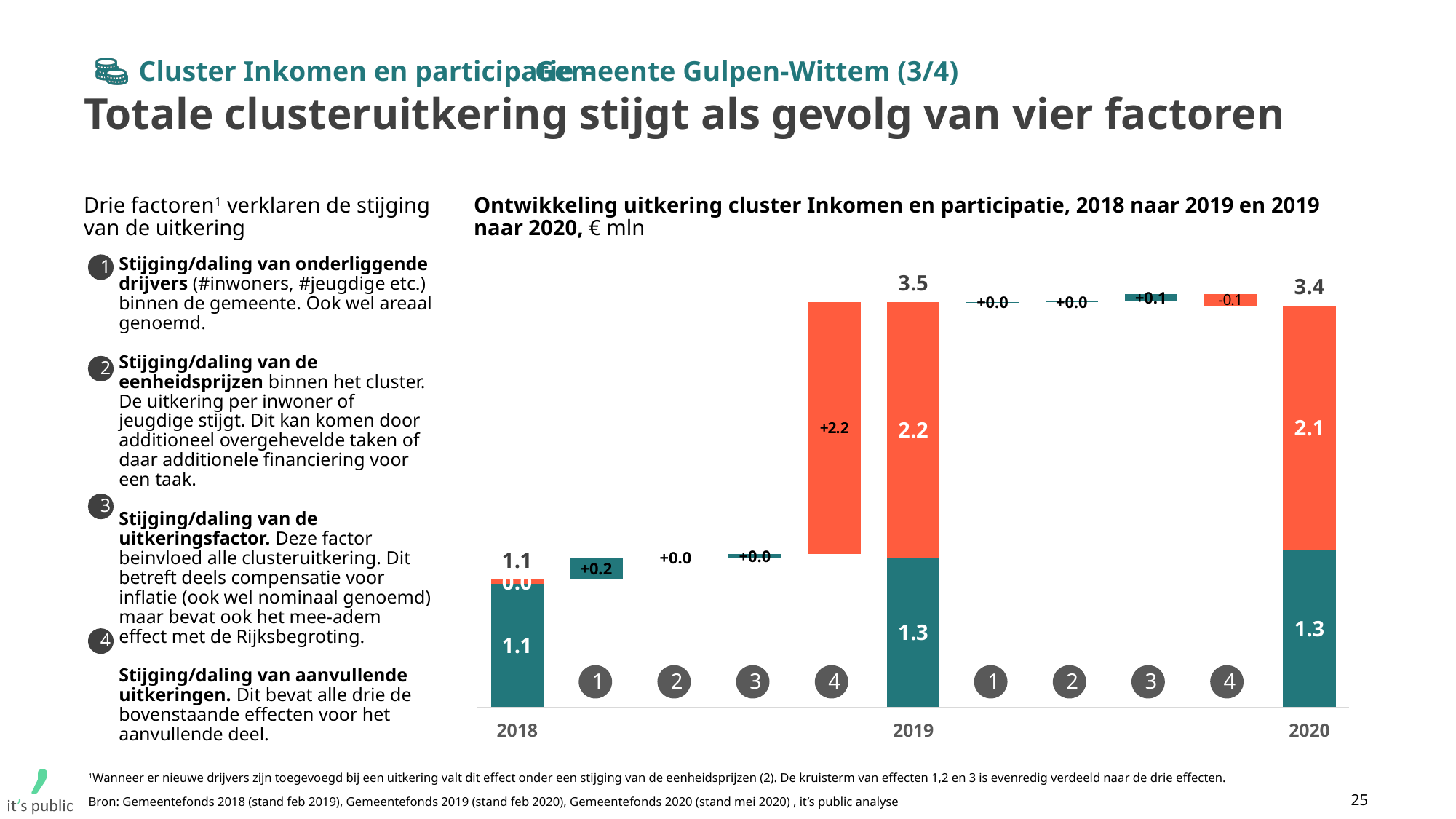
What is the total uitkering shown for 2018? 1.1 What is the total uitkering shown for 2019? 3.5 What is the total uitkering shown for 2020? 3.4 Which year has the highest total uitkering? 2019 By how much does the total uitkering increase from 2018 to 2019? 2.4 What is the value of the factor 4 step between 2018 and 2019? +2.2 Is the total for 2019 or the total for 2020 larger? 2019 What is the value of the factor 4 step between 2019 and 2020? -0.1 What is the value of the orange (upper) segment of the 2020 bar? 2.1 What is the value of the factor 1 step between 2018 and 2019? +0.2 What kind of chart is shown on the slide? Bar chart (waterfall) What is the value of the teal (lower) segment of the 2019 bar? 1.3